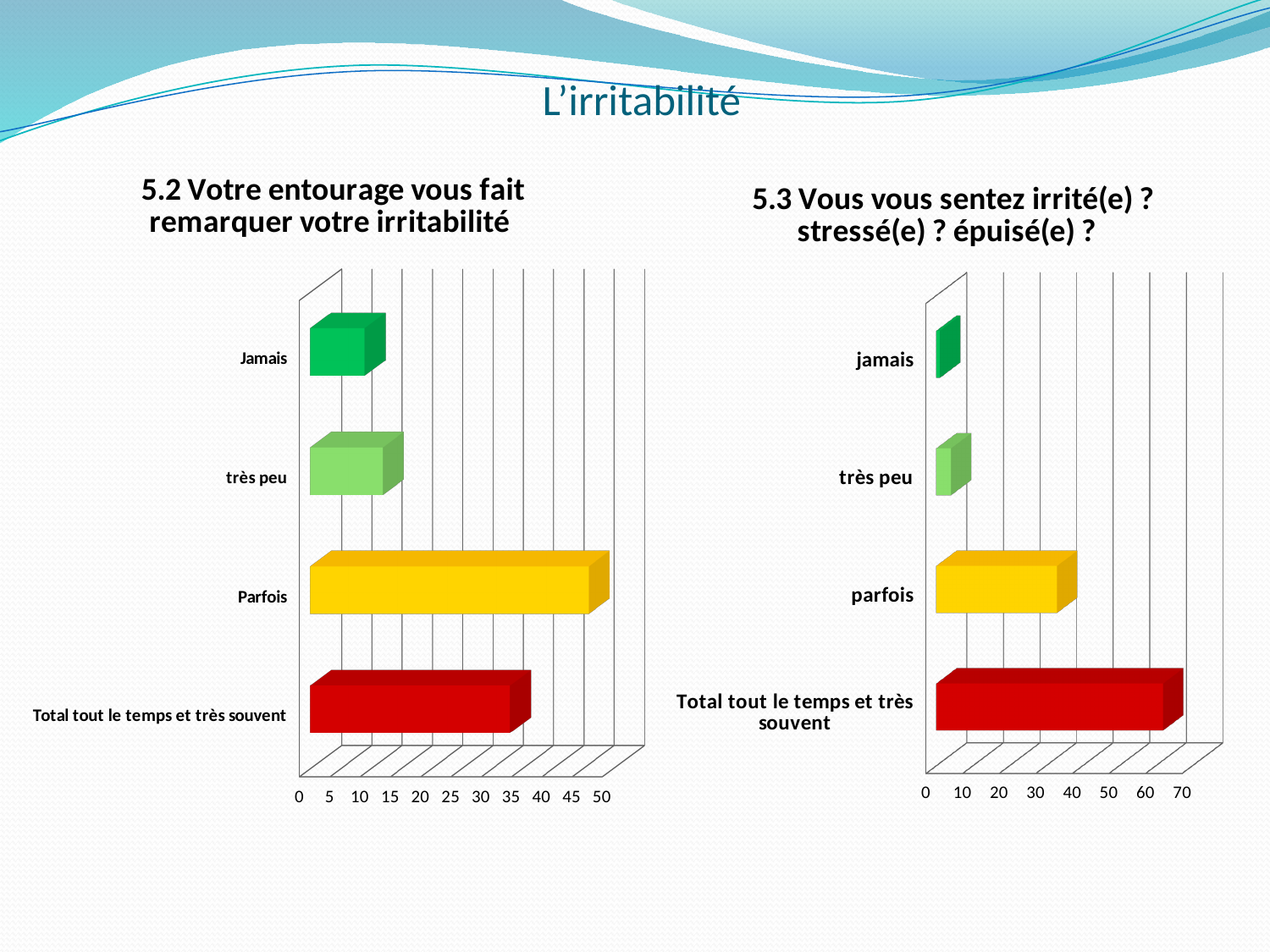
In the chart titled "5.2 Votre entourage vous fait remarquer votre irritabilité", which category has the highest value? Parfois In the left chart (5.2), is the value for Jamais greater or less than 15? less In the chart titled "5.2 Votre entourage vous fait remarquer votre irritabilité", which category has the lowest value? Jamais In the chart titled "5.3 Vous vous sentez irrité(e) ? stressé(e) ? épuisé(e) ?", which category has the lowest value? jamais What kind of chart is the right chart (5.3)? Bar chart In the left chart (5.2), which is larger: the value for Parfois or the value for "Total tout le temps et très souvent"? Parfois In the right chart (5.3), is the value for "Total tout le temps et très souvent" greater or less than 50? greater How many categories are shown in the left chart (5.2)? 4 In the right chart (5.3), is the value for jamais greater or less than 10? less In the chart titled "5.3 Vous vous sentez irrité(e) ? stressé(e) ? épuisé(e) ?", which category has the highest value? Total tout le temps et très souvent